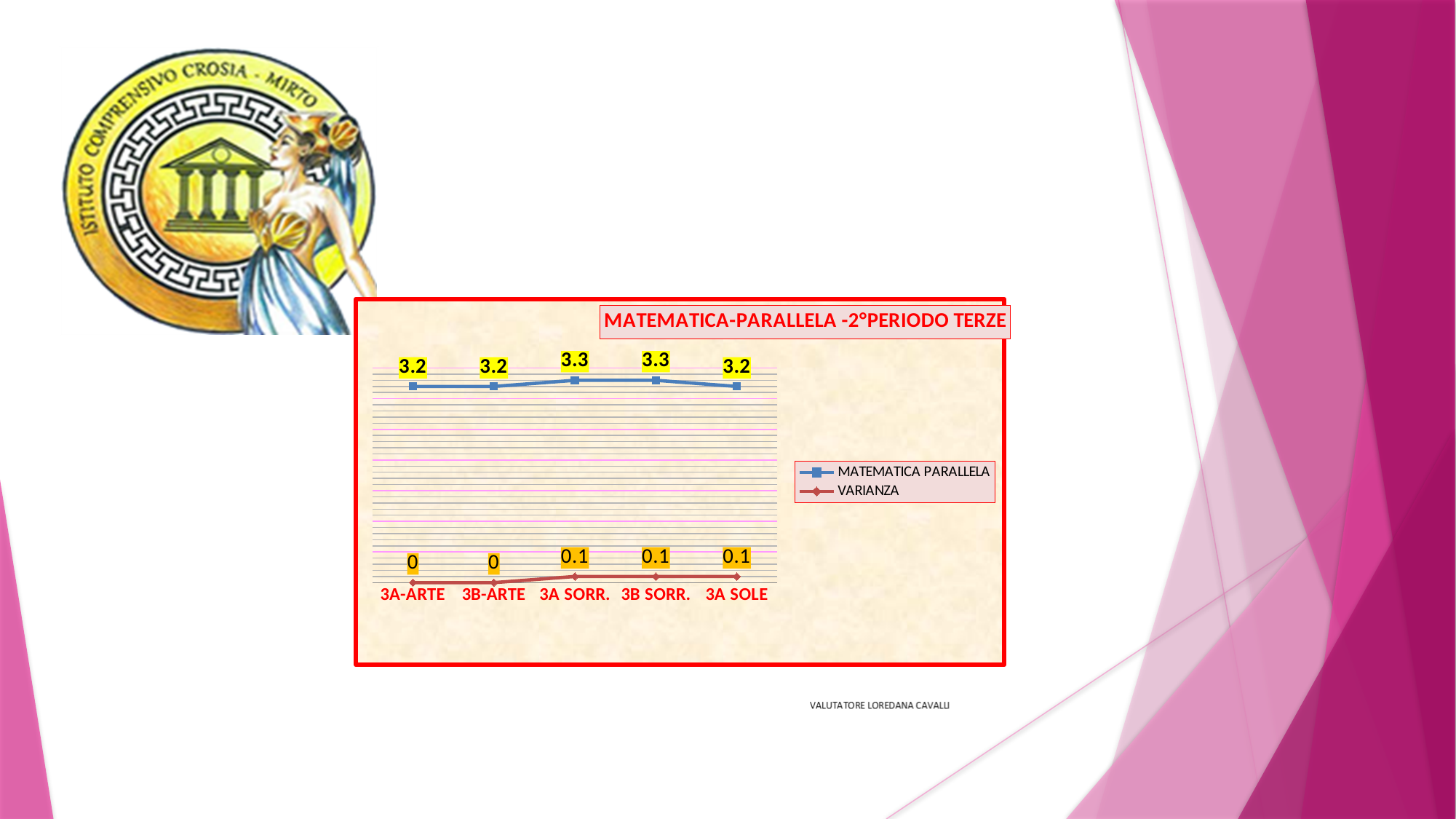
What is the MATEMATICA PARALLELA value for 3A SOLE? 3.2 What type of chart is shown on the slide? line chart How many categories are shown on the x axis? 5 How many series does the legend list? 2 Which is larger, the MATEMATICA PARALLELA value for 3A SORR. or for 3A-ARTE? 3A SORR. Which series is drawn in blue? MATEMATICA PARALLELA What is the difference between the VARIANZA values for 3A SOLE and 3A-ARTE? 0.1 What is the VARIANZA value for 3B SORR.? 0.1 What is the difference between the MATEMATICA PARALLELA values for 3B SORR. and 3B-ARTE? 0.1 What is the MATEMATICA PARALLELA value for 3A SORR.? 3.3 What is the title of the chart? MATEMATICA-PARALLELA -2°PERIODO TERZE What is the VARIANZA value for 3B-ARTE? 0